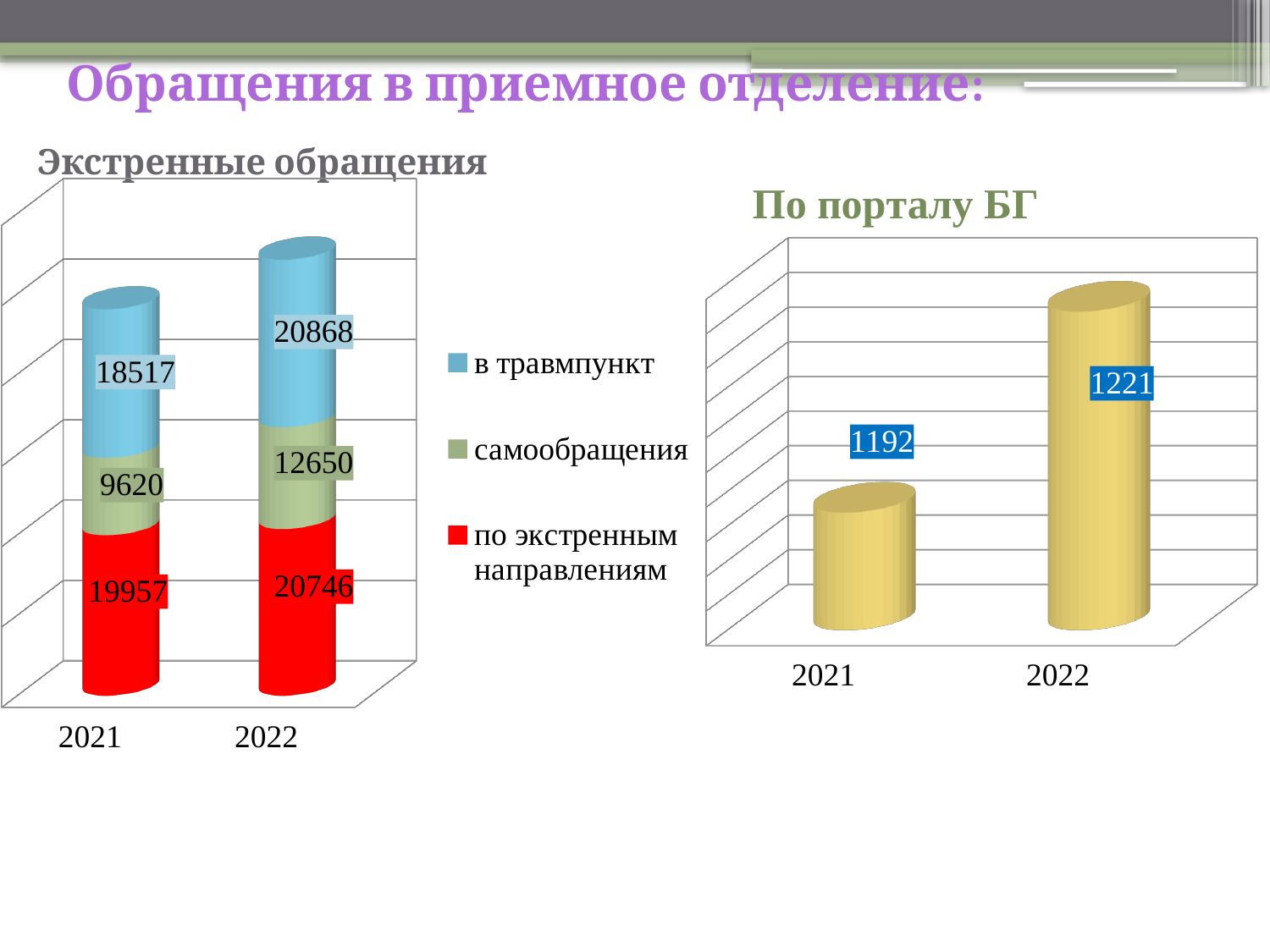
In the chart 'По порталу БГ', what is the value for 2021? 1192 In the chart 'По порталу БГ', which year has the higher value? 2022 In the chart 'Экстренные обращения', what is the value for 'самообращения' in 2021? 9620 In the chart 'Экстренные обращения', what is the value for 'по экстренным направлениям' in 2022? 20746 How many series does the legend of the chart 'Экстренные обращения' list? 3 In the chart 'Экстренные обращения', which is larger in 2021: 'в травмпункт' or 'самообращения'? в травмпункт In the chart 'Экстренные обращения', what is the total of the stacked bar for 2021? 48094 In the chart 'Экстренные обращения', what is the total of the stacked bar for 2022? 54264 In the chart 'Экстренные обращения', what is the value for 'в травмпункт' in 2022? 20868 In the chart 'По порталу БГ', what is the difference between the 2022 and 2021 values? 29 What kind of chart is 'По порталу БГ'? bar chart In the chart 'Экстренные обращения', by how much did 'самообращения' increase from 2021 to 2022? 3030